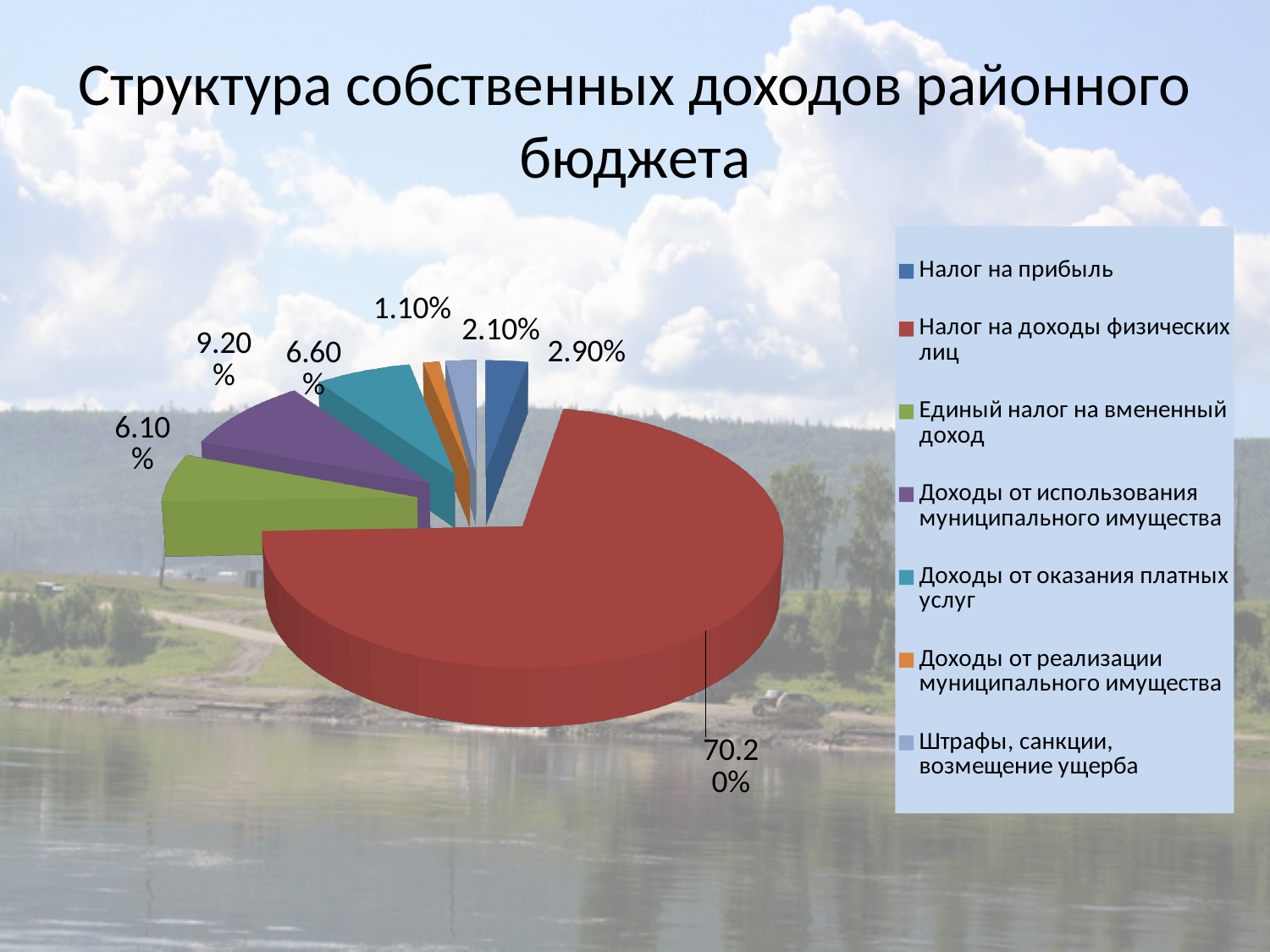
Which is larger: the share for Налог на прибыль or the share for Штрафы, санкции, возмещение ущерба? Налог на прибыль What is the share for Доходы от оказания платных услуг? 6.60% Which category has the largest share of the pie? Налог на доходы физических лиц Which category has the smallest share of the pie? Доходы от реализации муниципального имущества How many categories does the legend list? 7 What is the share for Доходы от использования муниципального имущества? 9.20% What is the share for Штрафы, санкции, возмещение ущерба? 2.10% What kind of chart is shown on the slide? pie chart What is the share for Налог на прибыль? 2.90% What is the share for Единый налог на вмененный доход? 6.10% What is the difference between the shares of Доходы от использования муниципального имущества and Единый налог на вмененный доход? 3.10% What is the share for Налог на доходы физических лиц? 70.20%